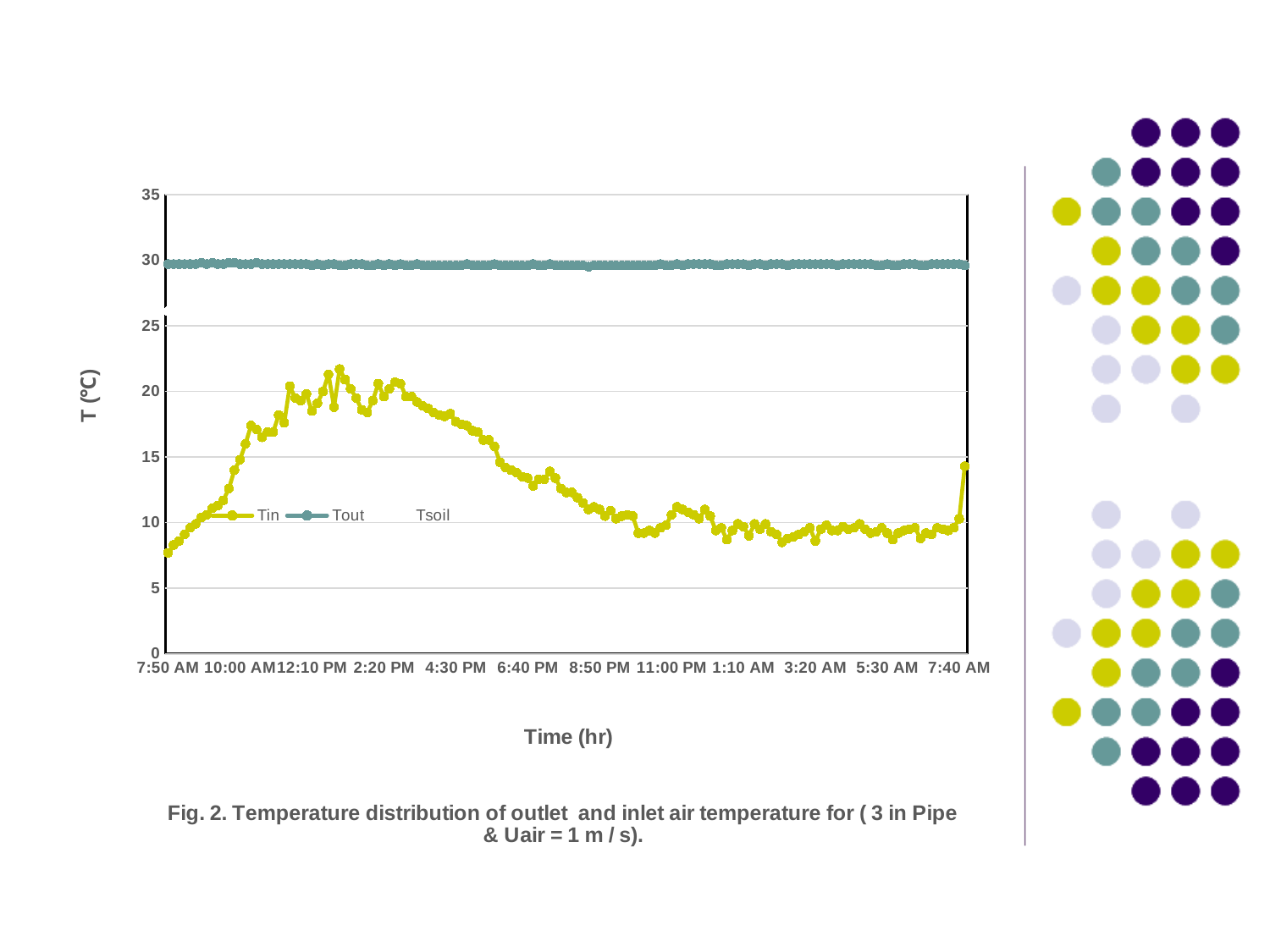
What kind of chart is shown on the slide? line chart Is the value of Tin at 7:50 AM greater or less than 10? less Is the value of Tin at 4:30 PM greater or less than 15? greater Which series is higher at 12:10 PM, Tin or Tout? Tout How many series does the legend list? 3 Is the value of Tout at 4:30 PM greater or less than 25? greater How many time labels are shown on the x axis? 12 What is the title of the y axis? T (°C) Does Tin rise or fall between 2:20 PM and 8:50 PM? fall Does Tin rise or fall between 7:50 AM and 12:10 PM? rise What is the title of the x axis? Time (hr)